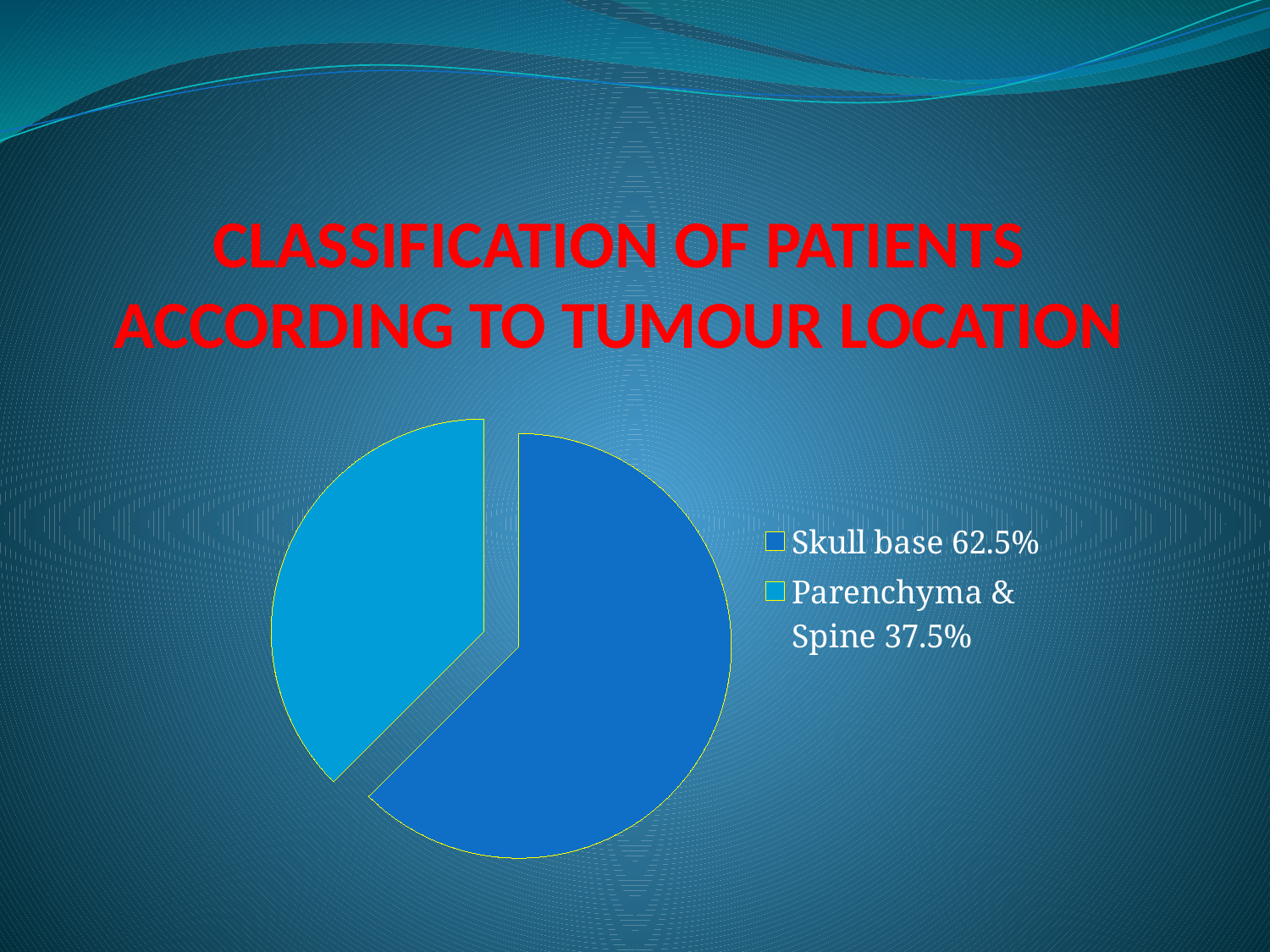
What share of patients had tumours at the skull base? 62.5% What is the title shown above the chart? CLASSIFICATION OF PATIENTS ACCORDING TO TUMOUR LOCATION What share of patients had tumours in the parenchyma & spine? 37.5% How many slices does the pie chart have? 2 Which tumour location accounts for the largest slice of the pie? Skull base What kind of chart is shown on the slide? Pie chart Which tumour location accounts for the smallest slice of the pie? Parenchyma & Spine Which is larger: the share for skull base or the share for parenchyma & spine? Skull base Which legend entry is shown in the lighter blue colour? Parenchyma & Spine 37.5% How many entries does the legend list? 2 What is the difference in percentage points between the skull base share and the parenchyma & spine share? 25